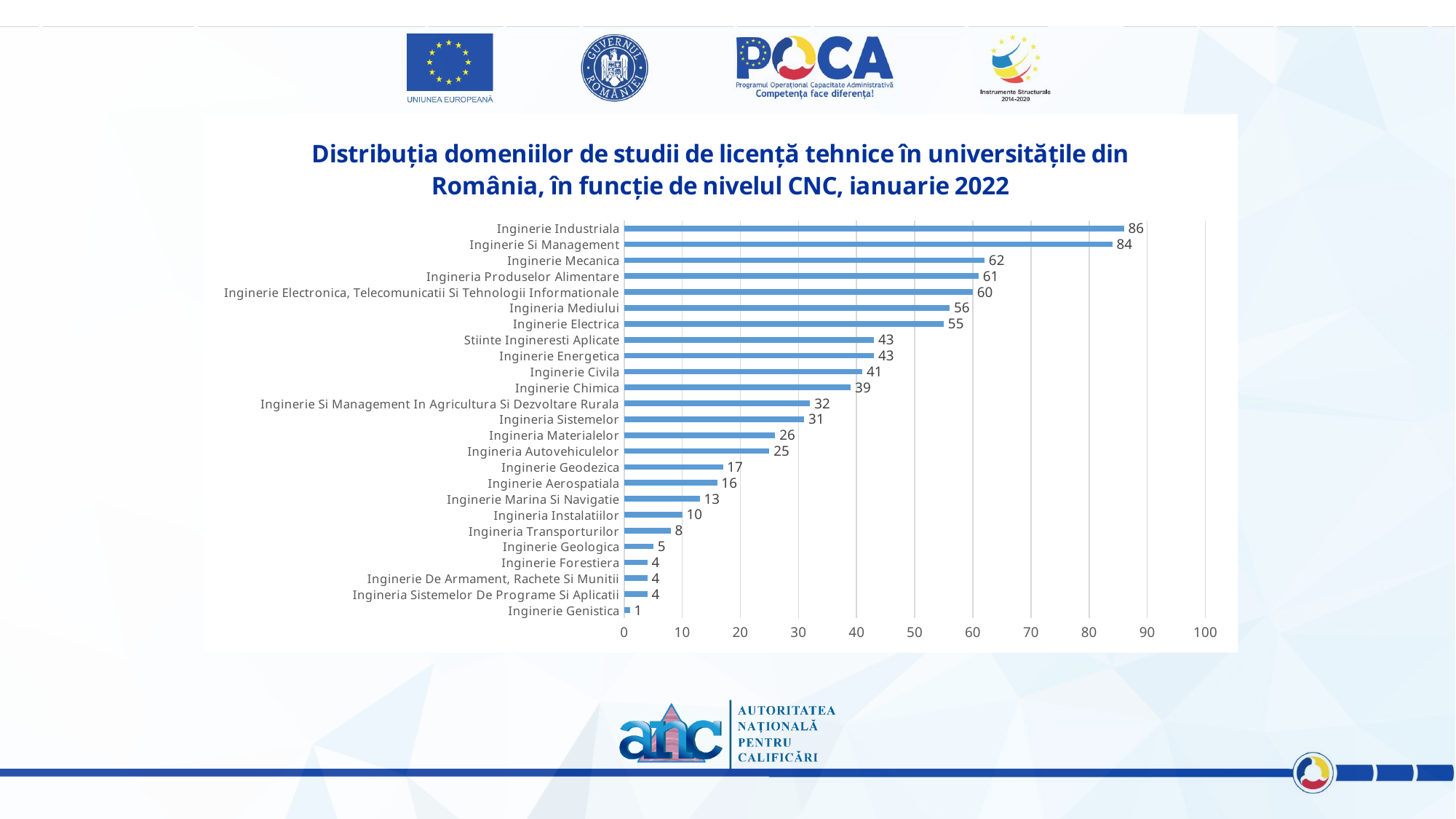
What is the maximum value shown on the horizontal axis? 100 What kind of chart is shown on the slide? bar chart What is the value for Inginerie Marina Si Navigatie? 13 Is the value for Ingineria Mediului greater or less than 50? greater What is the value for Inginerie Industriala? 86 What is the value for Inginerie Mecanica? 62 How many categories are shown in the chart? 25 Which is larger, the value for Inginerie Civila or the value for Inginerie Chimica? Inginerie Civila Which category has the lowest value? Inginerie Genistica What is the difference between the values for Inginerie Si Management and Inginerie Electrica? 29 Which category has the highest value? Inginerie Industriala What is the value for Ingineria Sistemelor? 31